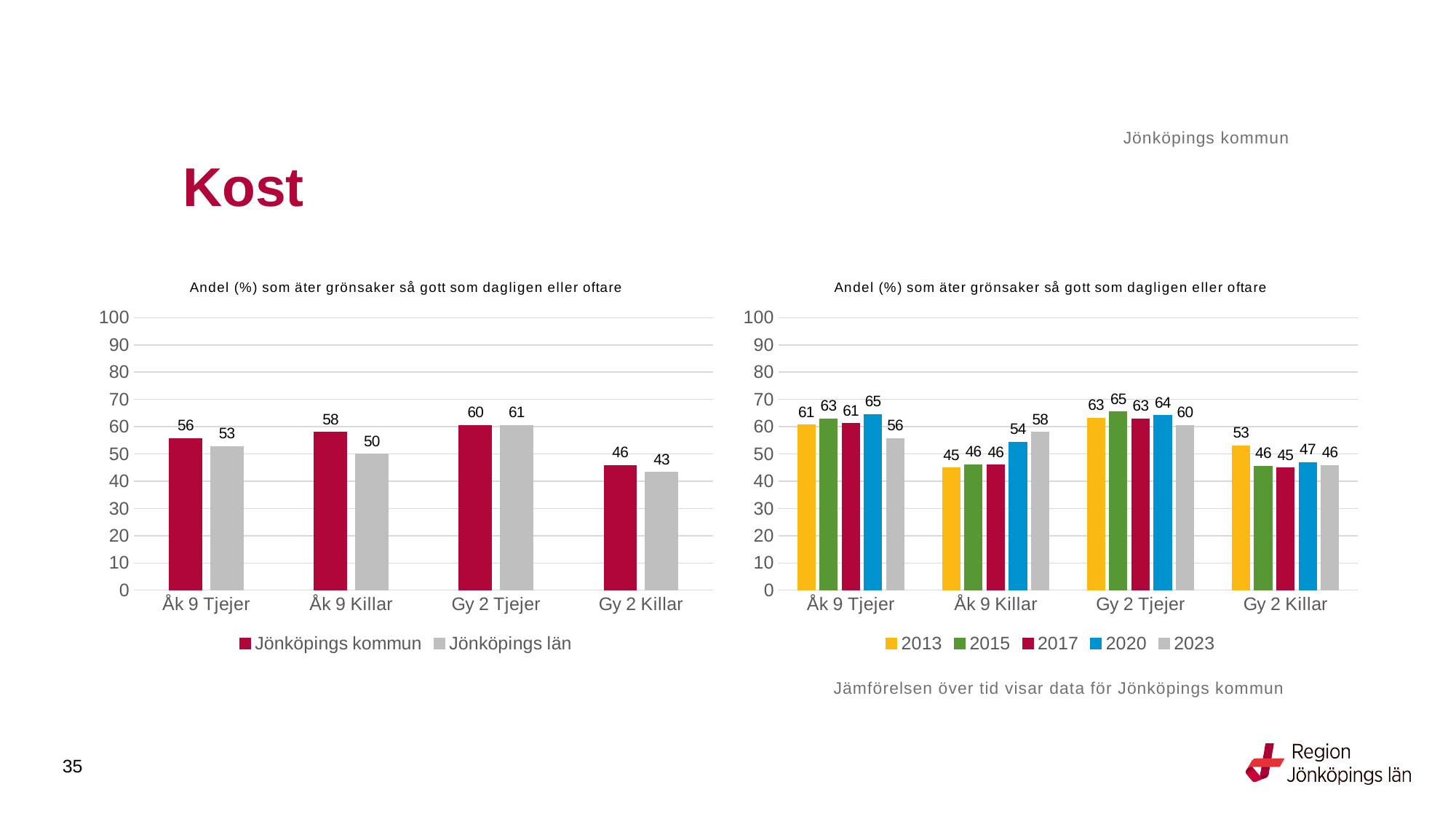
In the left chart, what is the difference between Jönköpings kommun and Jönköpings län for Åk 9 Killar? 8 In the right chart, which year has the highest value for Åk 9 Tjejer? 2020 In the right chart, what is the value for 2020 for Åk 9 Killar? 54 How many series does the legend of the left chart list? 2 What kind of chart is the right chart? Bar chart In the left chart, which is larger for Gy 2 Tjejer: Jönköpings kommun or Jönköpings län? Jönköpings län How many series does the legend of the right chart list? 5 In the right chart, what is the value for 2013 for Gy 2 Killar? 53 In the left chart, which category has the lowest value for Jönköpings kommun? Gy 2 Killar In the right chart, what is the difference between the 2023 and 2013 values for Åk 9 Killar? 13 In the left chart, what is the value for Jönköpings län for Gy 2 Killar? 43 In the left chart, what is the value for Jönköpings kommun for Åk 9 Killar? 58